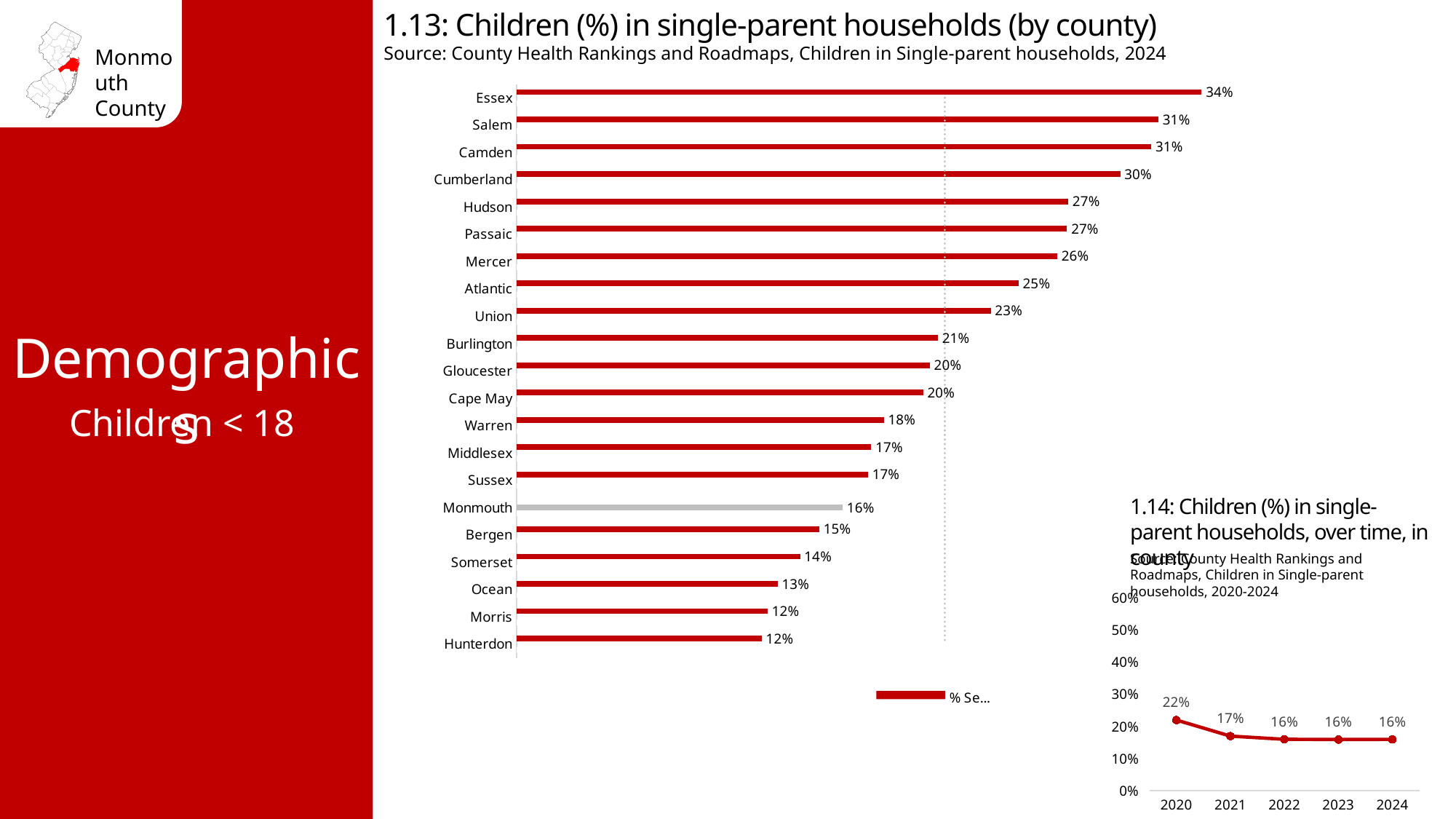
In chart 1.14 (over time), do the values rise or fall from 2020 to 2024? Fall In chart 1.14 (Children (%) in single-parent households over time), what is the value for 2020? 22% In chart 1.13 (by county), which county has the highest percentage of children in single-parent households? Essex In chart 1.14 (over time), what is the difference between the values for 2020 and 2021? 5% What kind of chart is chart 1.13 (Children (%) in single-parent households by county)? Bar chart In chart 1.13 (Children (%) in single-parent households by county), what is the value for Monmouth? 16% In chart 1.13 (by county), how many counties are shown? 21 In chart 1.13 (by county), what is the value for Cumberland? 30% In chart 1.13 (by county), what is the value for Hudson? 27% In chart 1.14 (over time), how many years are plotted? 5 In chart 1.13 (by county), which is larger, the value for Union or the value for Bergen? Union In chart 1.13 (by county), what is the difference between the values for Essex and Monmouth? 18%